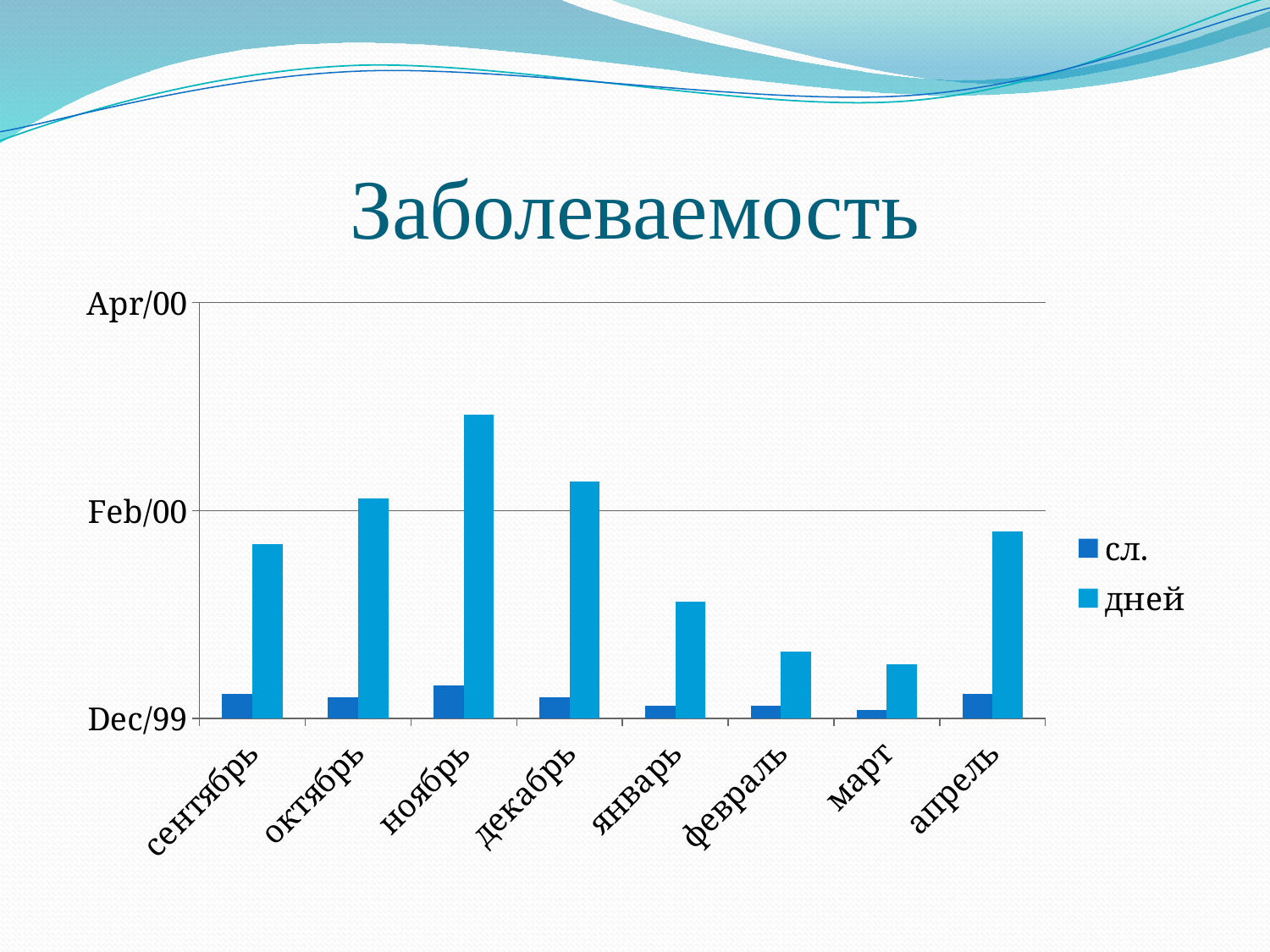
How many series does the legend list? 2 What are the names of the series in the legend? сл. and дней What kind of chart is shown on the slide? bar chart What is the title of the chart? Заболеваемость Which month has the highest value for дней? ноябрь Which month has the lowest value for дней? март How many months (categories) are shown on the x axis? 8 Which month has the lowest value for сл.? март For дней, which is larger: октябрь or декабрь? декабрь Which month has the highest value for сл.? ноябрь For дней, which is larger: сентябрь or январь? сентябрь For дней, which is larger: февраль or март? февраль